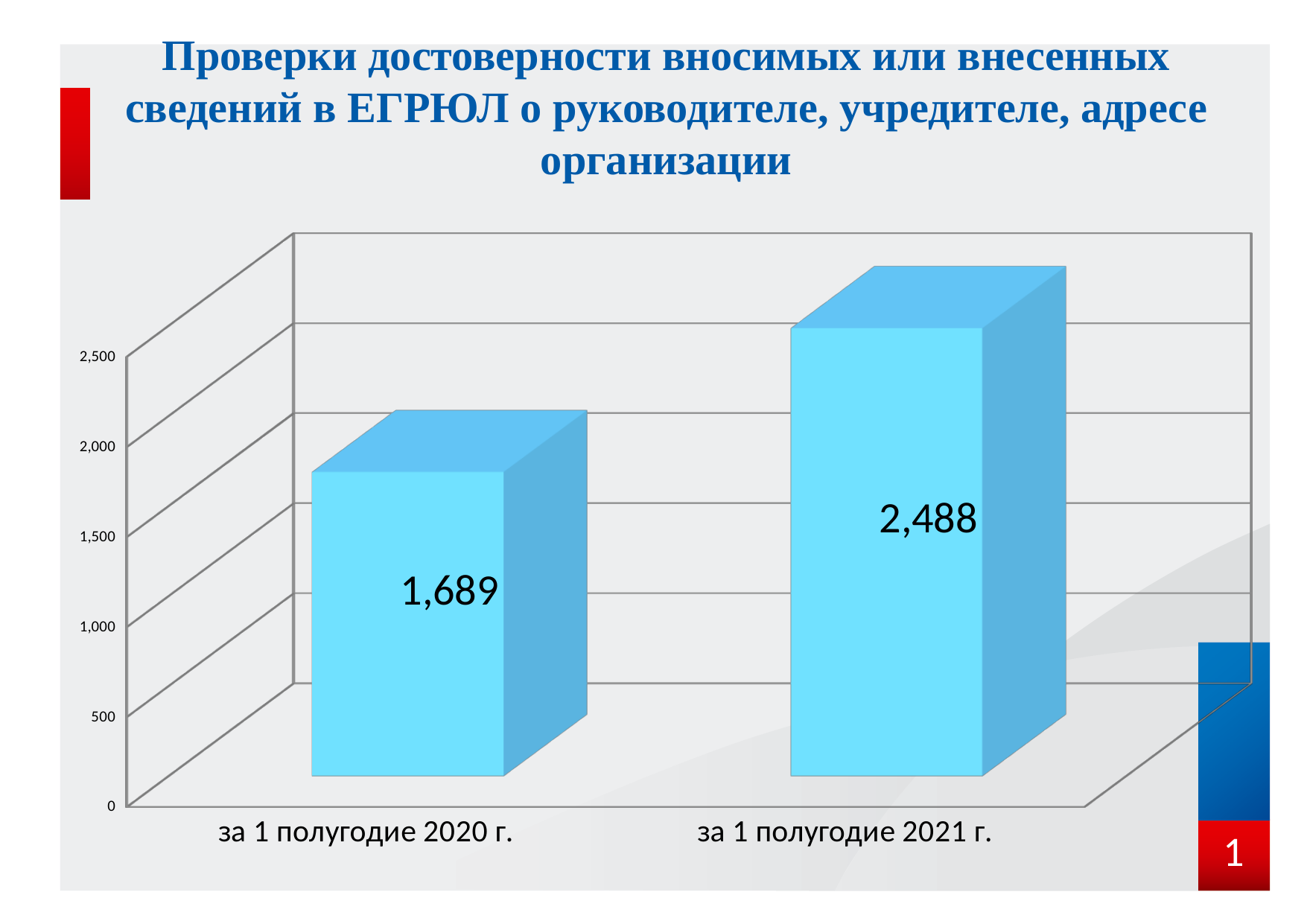
What is the highest value labelled on the vertical axis? 2,500 What is the value for за 1 полугодие 2020 г.? 1,689 Which category has the highest value? за 1 полугодие 2021 г. Is the value for за 1 полугодие 2020 г. greater or less than 2,000? less Is the value for за 1 полугодие 2021 г. greater or less than 2,000? greater Do the values rise or fall from за 1 полугодие 2020 г. to за 1 полугодие 2021 г.? rise What is the difference between the values for за 1 полугодие 2021 г. and за 1 полугодие 2020 г.? 799 What is the value for за 1 полугодие 2021 г.? 2,488 Which category has the lowest value? за 1 полугодие 2020 г. Which is larger: the value for за 1 полугодие 2020 г. or the value for за 1 полугодие 2021 г.? за 1 полугодие 2021 г. How many categories are shown on the chart? 2 What kind of chart is shown on the slide? bar chart